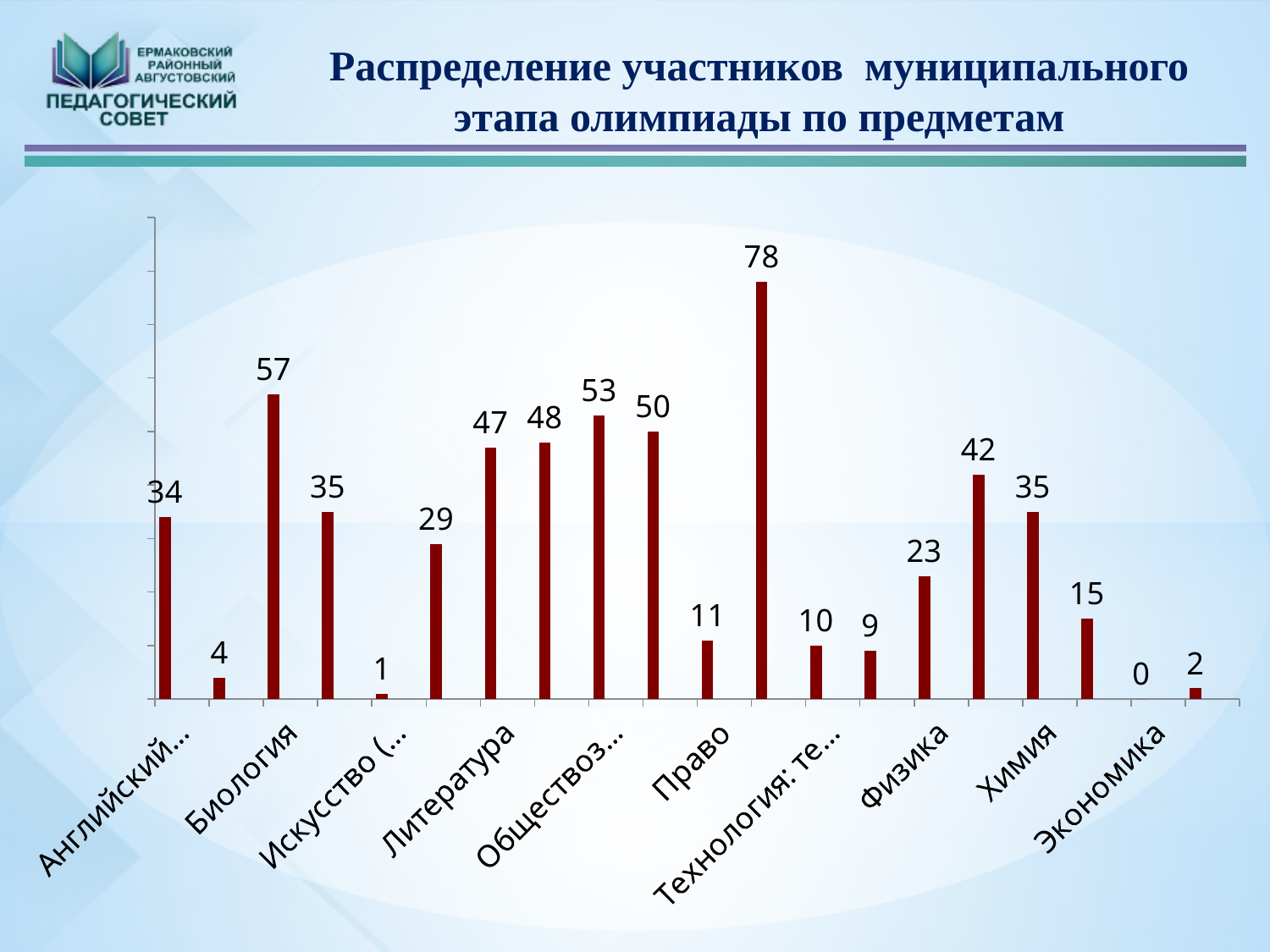
Which of the labelled categories has the lowest value? Экономика What is the value for Биология? 57 What is the value for Физика? 23 What is the title of the chart on the slide? Распределение участников муниципального этапа олимпиады по предметам Which has the larger value, Биология or Физика? Биология What is the value for Химия? 35 What is the highest value shown in the chart? 78 How many bars are plotted in the chart? 19 What is the value for Экономика? 0 What is the value for Литература? 47 What is the difference between the values for Биология and Химия? 22 What kind of chart is shown on the slide? bar chart